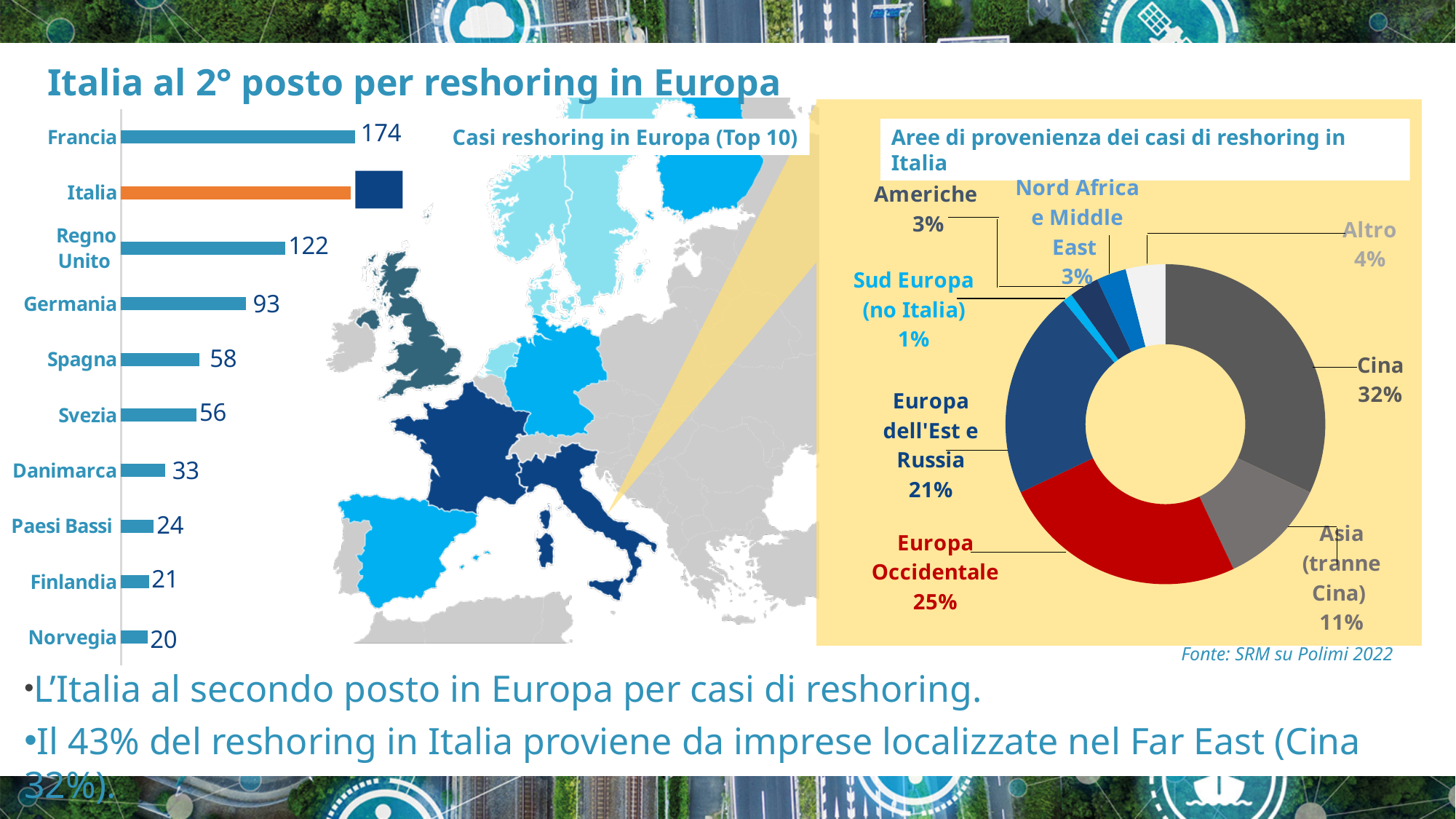
In the bar chart 'Casi reshoring in Europa (Top 10)', what is the difference between the values for Francia and Regno Unito? 52 In the bar chart 'Casi reshoring in Europa (Top 10)', what is the value for Germania? 93 In the bar chart 'Casi reshoring in Europa (Top 10)', which country has the lowest value? Norvegia In the chart 'Aree di provenienza dei casi di reshoring in Italia', what is the difference between the shares of Europa Occidentale and Europa dell'Est e Russia? 4% In the chart 'Aree di provenienza dei casi di reshoring in Italia', which area has the smallest share? Sud Europa (no Italia) What kind of chart is 'Aree di provenienza dei casi di reshoring in Italia'? Pie (donut) chart In the chart 'Aree di provenienza dei casi di reshoring in Italia', what share does Cina have? 32% In the bar chart 'Casi reshoring in Europa (Top 10)', which country has the highest value? Francia How many countries are shown in the bar chart 'Casi reshoring in Europa (Top 10)'? 10 What kind of chart is 'Casi reshoring in Europa (Top 10)'? Bar chart In the bar chart 'Casi reshoring in Europa (Top 10)', what is the value for Francia? 174 In the bar chart 'Casi reshoring in Europa (Top 10)', which has a larger value, Danimarca or Paesi Bassi? Danimarca